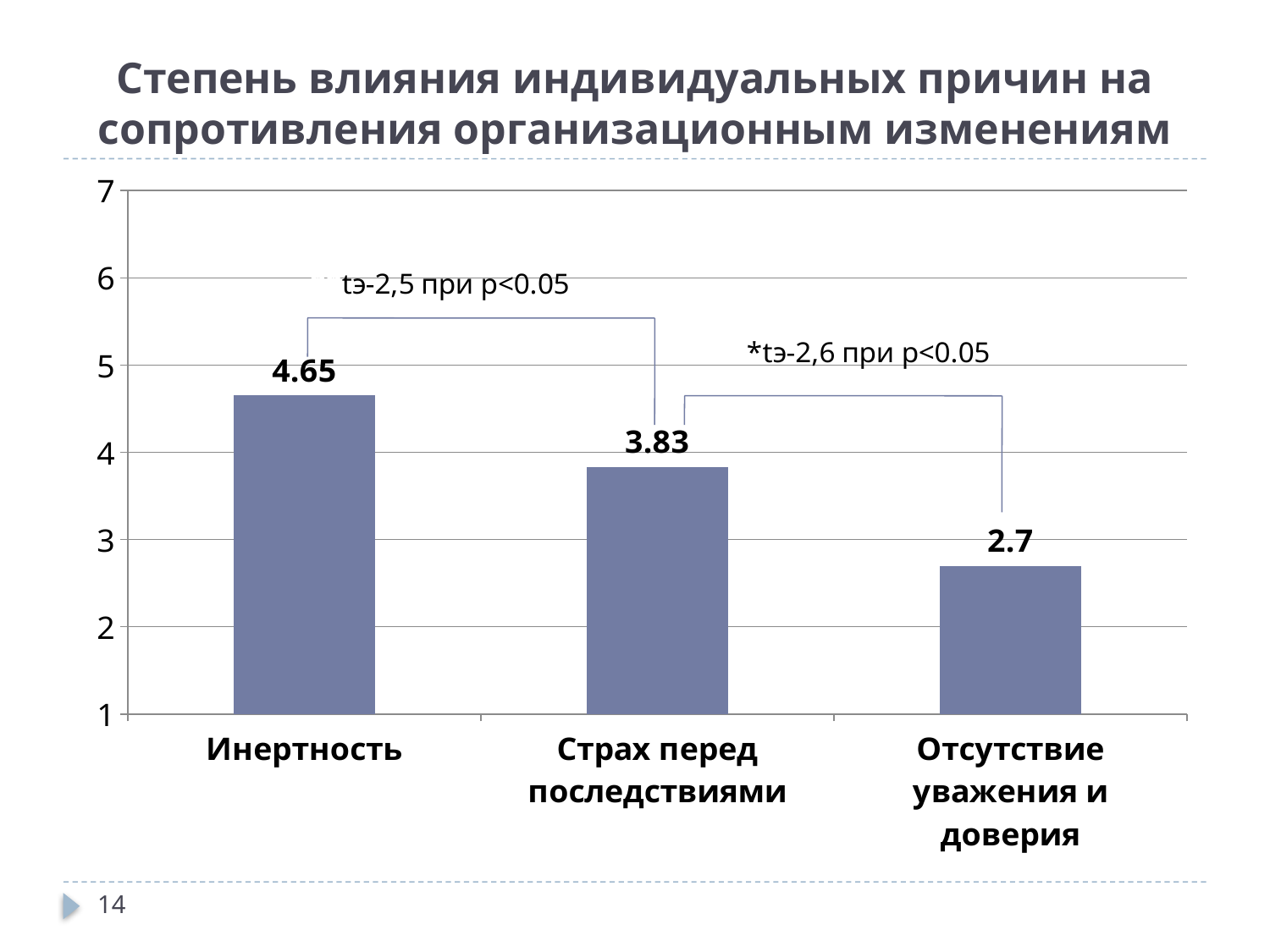
Which category has the lowest value? Отсутствие уважения и доверия What is the value for Страх перед последствиями? 3.83 What is the difference between the values for Страх перед последствиями and Отсутствие уважения и доверия? 1.13 What kind of chart is shown on the slide? bar chart Which is larger, the value for Инертность or the value for Отсутствие уважения и доверия? Инертность Is the value for Страх перед последствиями greater or less than 4? less What is the value for Отсутствие уважения и доверия? 2.7 What is the difference between the values for Инертность and Страх перед последствиями? 0.82 What is the value for Инертность? 4.65 How many categories are shown in the chart? 3 Do the values rise or fall from left to right across the categories? fall Which category has the highest value? Инертность